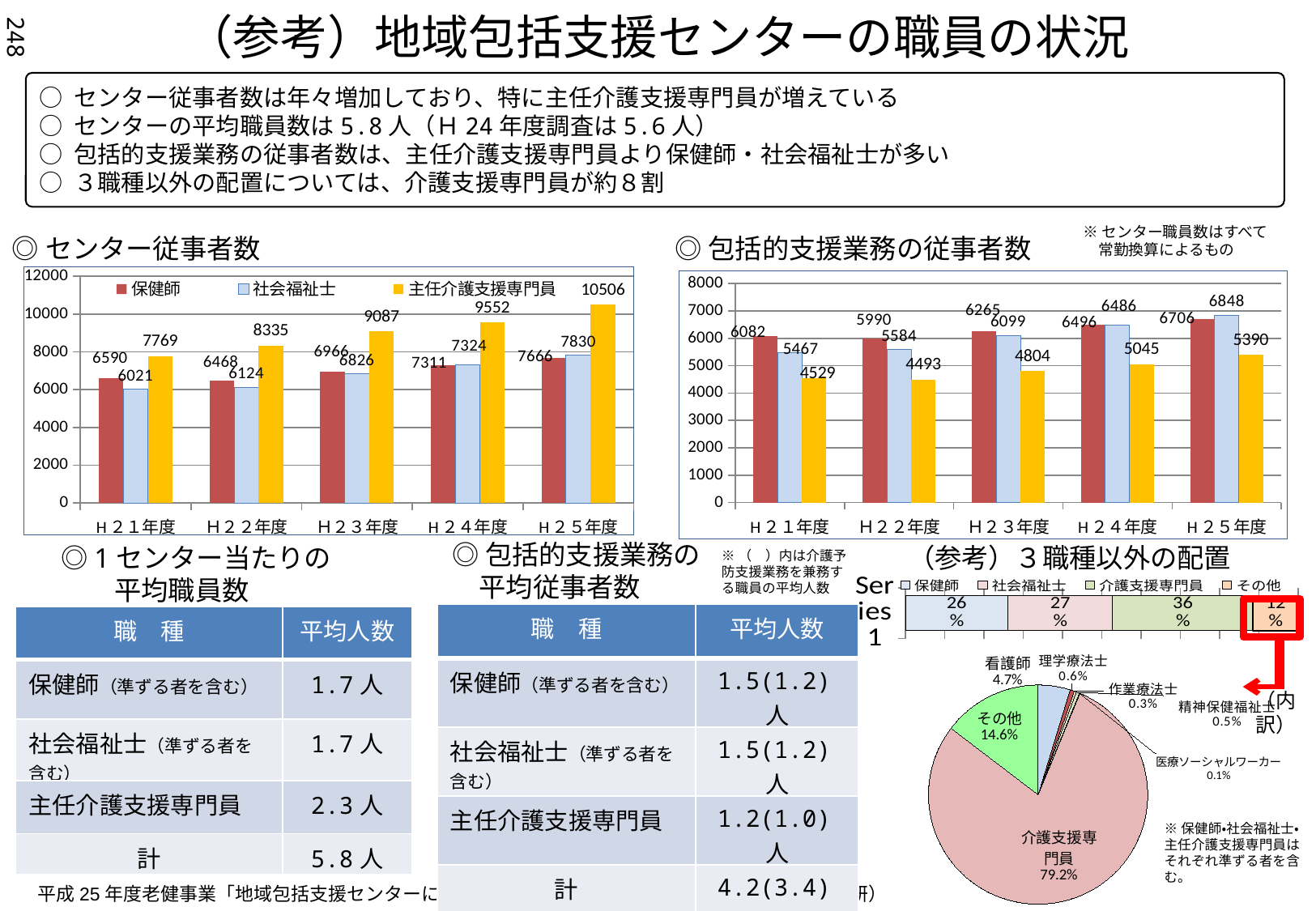
In the センター従事者数 chart, what is the difference between 主任介護支援専門員 and 保健師 in Ｈ２５年度? 2840 In the （参考）３職種以外の配置 stacked bar, what share is 介護支援専門員? 36% In the センター従事者数 chart, how many series does the legend list? 3 In the 包括的支援業務の従事者数 chart, what is the value for 社会福祉士 in Ｈ２５年度? 6848 In the 包括的支援業務の従事者数 chart, which is larger in Ｈ２３年度: 保健師 or 主任介護支援専門員? 保健師 In the 包括的支援業務の従事者数 chart, is the value for 主任介護支援専門員 in Ｈ２１年度 greater or less than 5000? less In the センター従事者数 chart, what is the value for 保健師 in Ｈ２１年度? 6590 In the センター従事者数 chart, what is the value for 主任介護支援専門員 in Ｈ２５年度? 10506 In the 包括的支援業務の従事者数 chart, which series has the lowest value in Ｈ２２年度? 主任介護支援専門員 In the pie chart at the bottom right, what share is 介護支援専門員? 79.2% In the センター従事者数 chart, does the value for 主任介護支援専門員 rise or fall from Ｈ２１年度 to Ｈ２５年度? rise In the 包括的支援業務の従事者数 chart, how many fiscal-year categories are shown on the x axis? 5